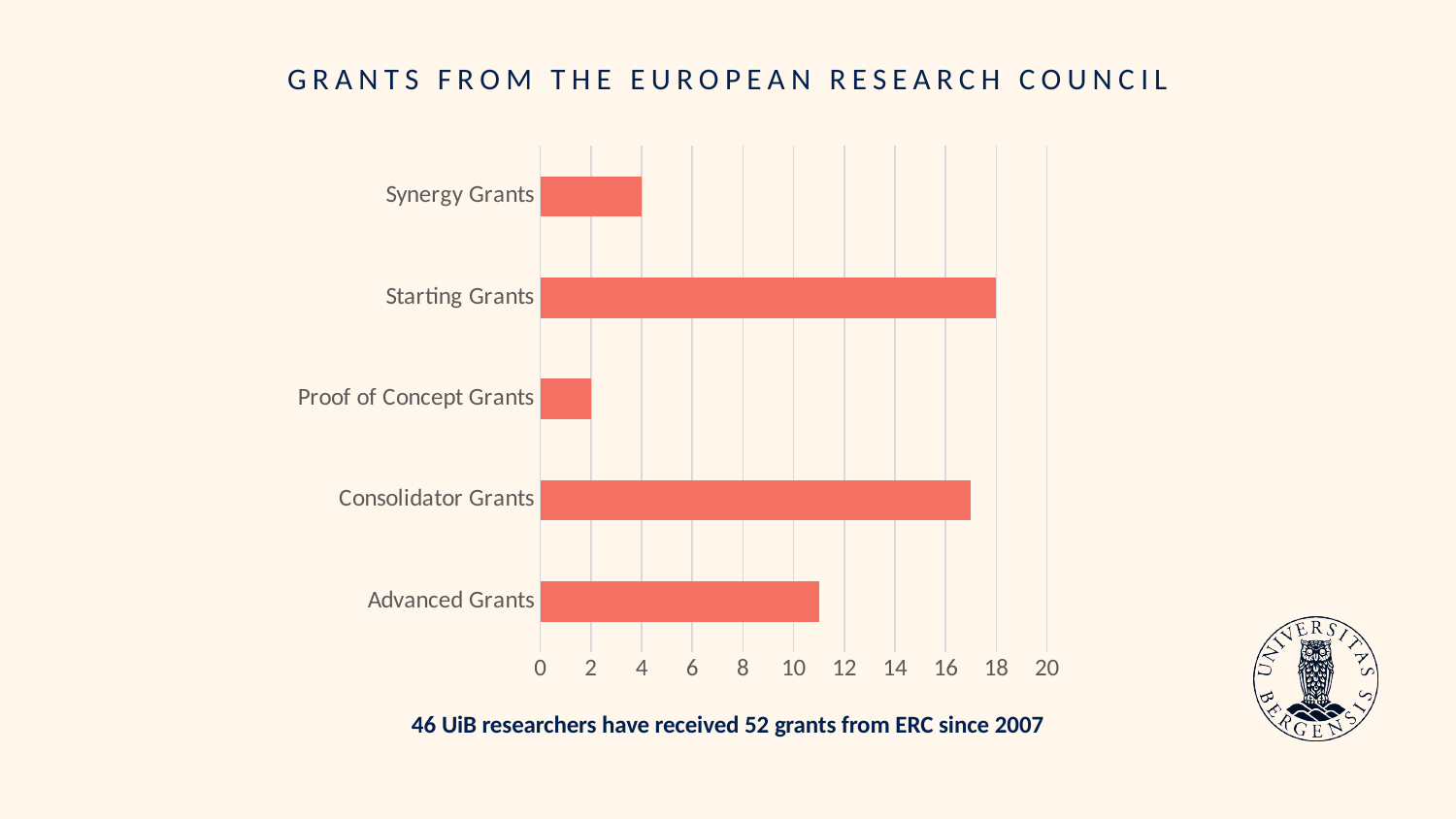
What type of chart is shown on the slide? bar chart Is the value for Advanced Grants greater or less than 12? less What is the value for Synergy Grants? 4 Which is larger, the value for Advanced Grants or the value for Synergy Grants? Advanced Grants Is the value for Consolidator Grants greater or less than 16? greater Which grant category has the lowest value? Proof of Concept Grants What is the title of the chart? Grants from the European Research Council How many grant categories are shown in the chart? 5 What is the value for Starting Grants? 18 What is the value for Proof of Concept Grants? 2 What is the difference between the values for Starting Grants and Synergy Grants? 14 Which is larger, the value for Synergy Grants or the value for Proof of Concept Grants? Synergy Grants